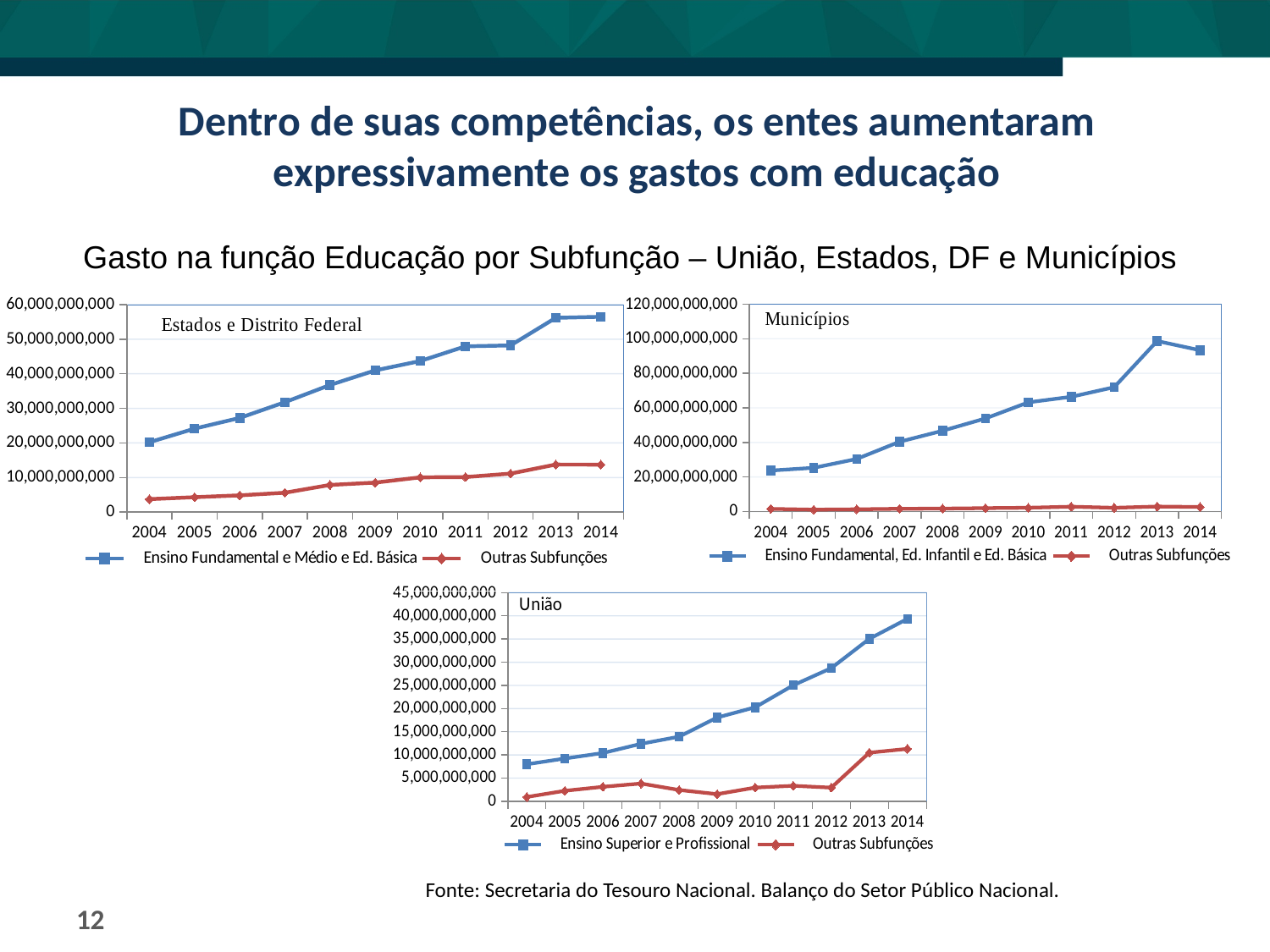
In the 'União' chart, is the 2004 value for 'Ensino Superior e Profissional' greater or less than 10,000,000,000? less In the 'Municípios' chart, how many years are plotted along the x axis? 11 What is the name of the first series in the legend of the 'Estados e Distrito Federal' chart? Ensino Fundamental e Médio e Ed. Básica In the 'Municípios' chart, is the 2013 value for 'Ensino Fundamental, Ed. Infantil e Ed. Básica' greater or less than 80,000,000,000? greater In the 'Municípios' chart, which year has the highest value for 'Ensino Fundamental, Ed. Infantil e Ed. Básica'? 2013 In the 'União' chart, does the 'Ensino Superior e Profissional' series rise or fall from 2004 to 2014? rise In the 'Estados e Distrito Federal' chart, is the 2014 value for 'Ensino Fundamental e Médio e Ed. Básica' greater or less than 50,000,000,000? greater In the 'Estados e Distrito Federal' chart, which year has the lowest value for 'Ensino Fundamental e Médio e Ed. Básica'? 2004 In the 'União' chart, which series has the larger value in 2012, 'Ensino Superior e Profissional' or 'Outras Subfunções'? Ensino Superior e Profissional What kind of chart is the 'Estados e Distrito Federal' chart? line chart In the 'União' chart, how many series does the legend list? 2